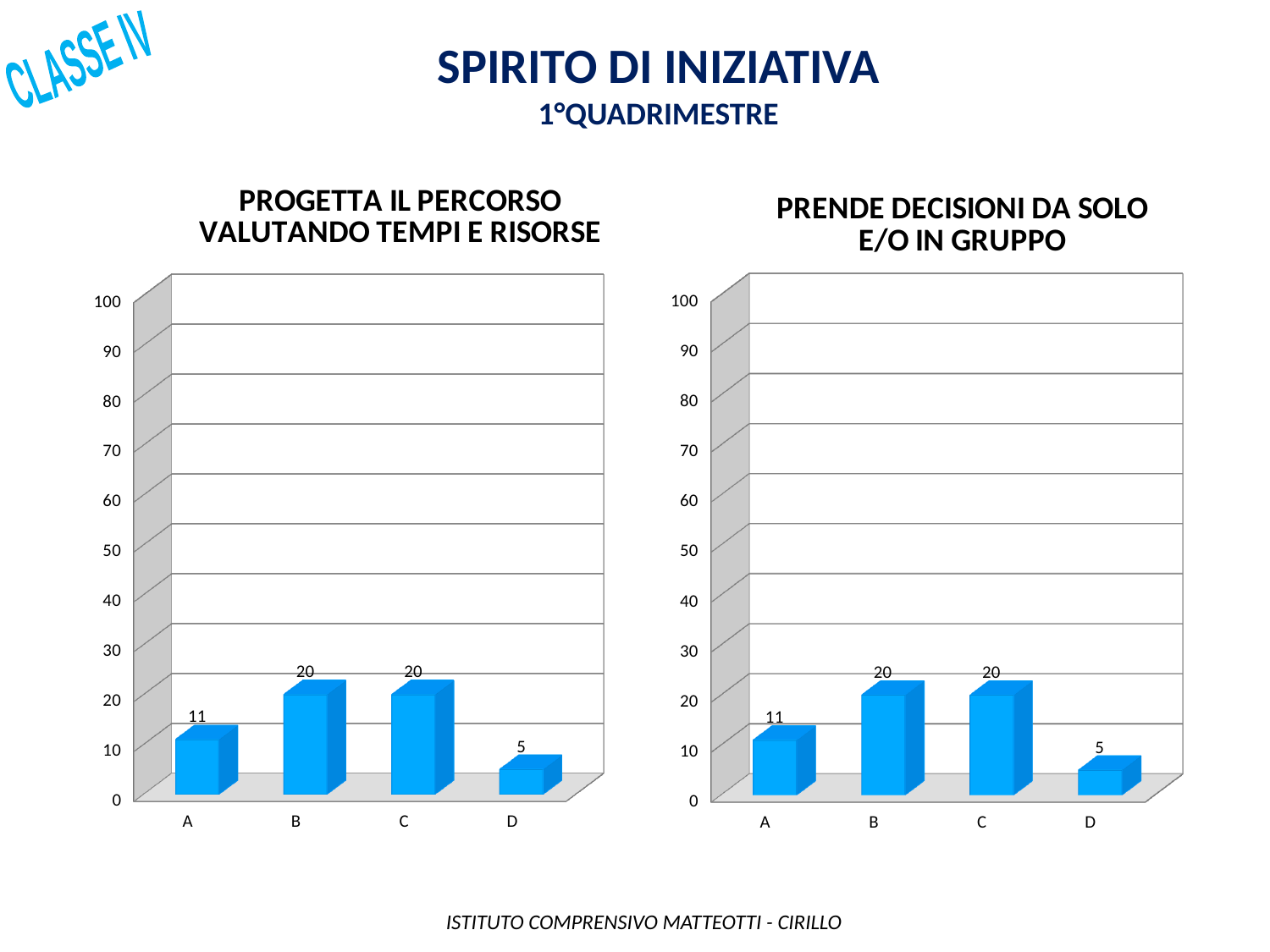
In the right chart, what is the difference between the values for B and A? 9 In the right chart, what is the difference between the values for A and D? 6 How many charts are shown on the slide? 2 In the left chart, which category has the lowest value? D What is the maximum value shown on the vertical axis of the left chart? 100 In the left chart, which is larger, the value for A or the value for D? A In the left chart, what is the value for category C? 20 What kind of chart is the chart titled 'PRENDE DECISIONI DA SOLO E/O IN GRUPPO'? bar chart In the chart titled 'PRENDE DECISIONI DA SOLO E/O IN GRUPPO', what is the value for category D? 5 How many categories are shown on the x axis of the left chart? 4 In the right chart, is the value for C greater or less than 30? less In the chart titled 'PROGETTA IL PERCORSO VALUTANDO TEMPI E RISORSE', what is the value for category A? 11